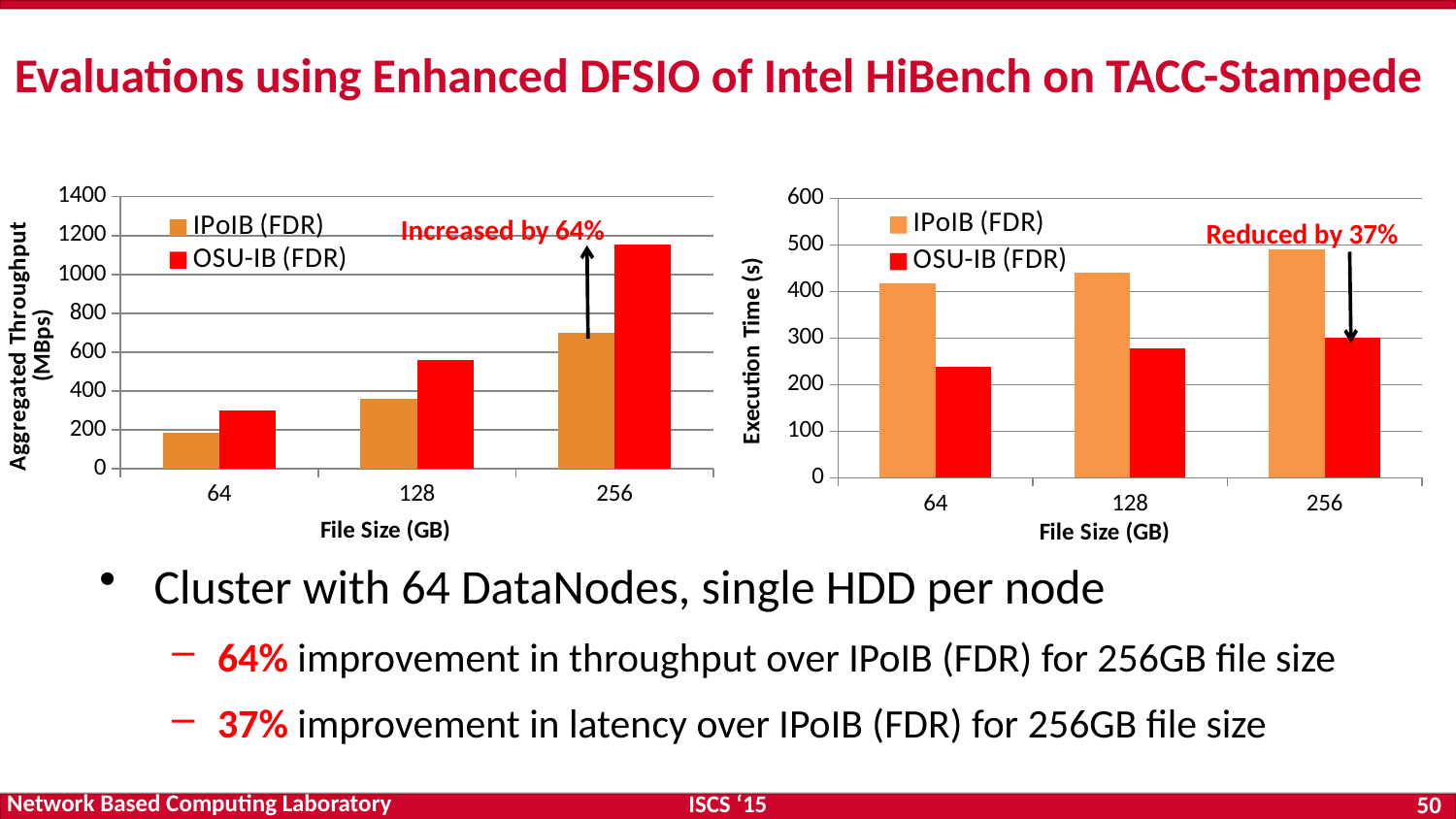
How many file size categories are shown on the x axis of the left chart (Aggregated Throughput)? 3 In the left chart (Aggregated Throughput), does the OSU-IB (FDR) throughput rise or fall as file size increases from 64 to 256 GB? rise In the left chart (Aggregated Throughput), is the OSU-IB (FDR) value at 256 GB greater or less than 1000? greater In the right chart (Execution Time), is the IPoIB (FDR) value at 256 GB greater or less than 400? greater In the left chart (Aggregated Throughput), at which file size is the IPoIB (FDR) throughput lowest? 64 In the right chart (Execution Time), at which file size is the IPoIB (FDR) execution time highest? 256 In the left chart (Aggregated Throughput), which series has the higher throughput at 256 GB, IPoIB (FDR) or OSU-IB (FDR)? OSU-IB (FDR) How many series does the legend of the right chart (Execution Time) list? 2 In the right chart (Execution Time), which series has the lower execution time at 128 GB, IPoIB (FDR) or OSU-IB (FDR)? OSU-IB (FDR) What type of chart is the left chart showing Aggregated Throughput? bar chart What is the y-axis label of the right chart? Execution Time (s)